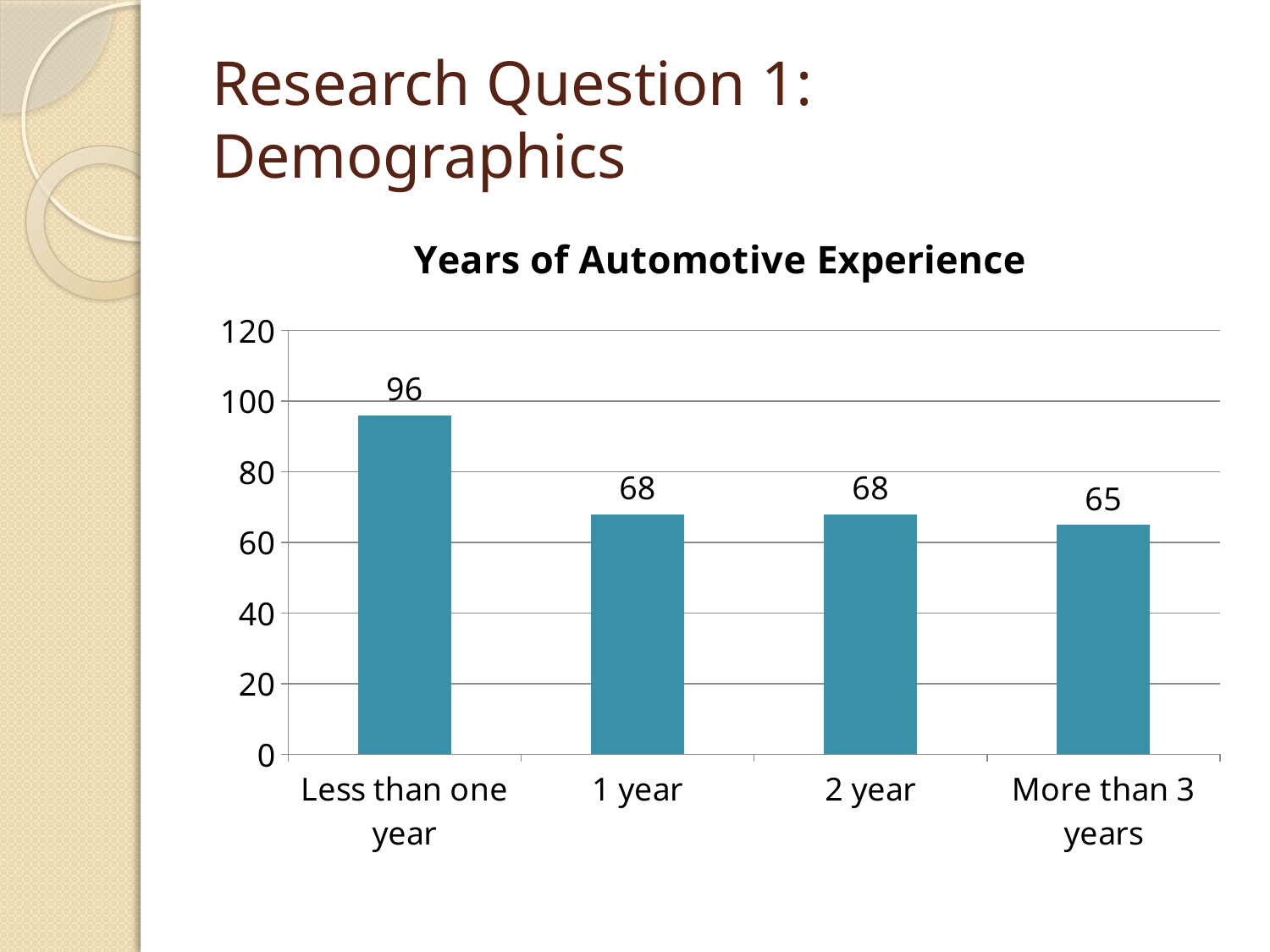
What is the difference between the values for "Less than one year" and "1 year"? 28 What kind of chart is shown on the slide? bar chart Which category has the lowest value? More than 3 years What is the difference between the values for "2 year" and "More than 3 years"? 3 Which is larger, the value for "Less than one year" or the value for "2 year"? Less than one year What is the title of the chart? Years of Automotive Experience How many categories are shown on the x axis? 4 What is the value for "Less than one year"? 96 Is the value for "1 year" greater or less than 80? less Which category has the highest value? Less than one year What is the value for "More than 3 years"? 65 What is the value for "1 year"? 68